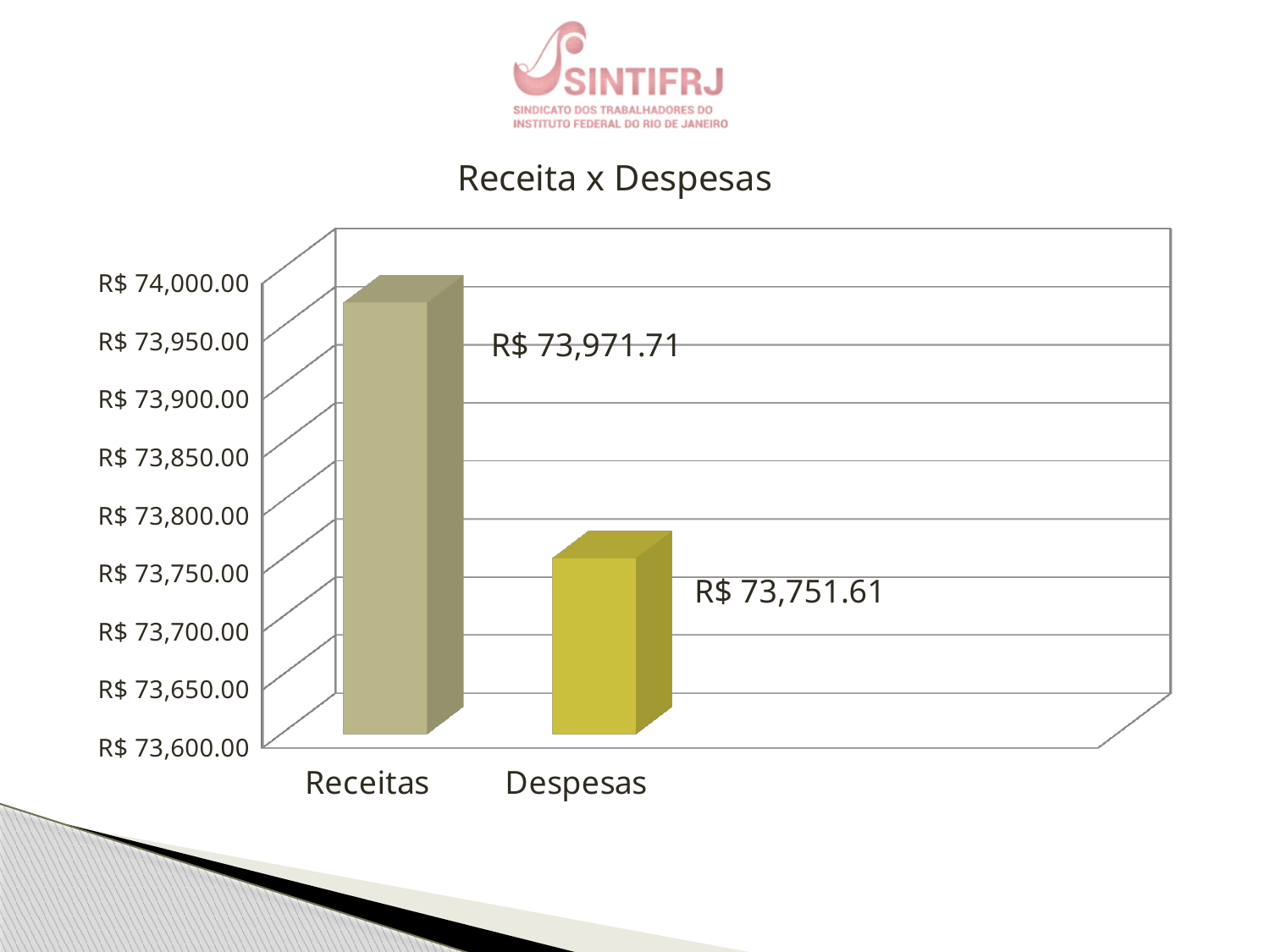
What is the value for Despesas? R$ 73,751.61 Is the value for Despesas greater or less than R$ 73,800.00? less What is the lowest value shown on the vertical axis? R$ 73,600.00 How many categories are shown on the x axis? 2 What is the difference between the values for Receitas and Despesas? R$ 220.10 What is the title of the chart? Receita x Despesas Which is larger, the value for Receitas or the value for Despesas? Receitas What is the value for Receitas? R$ 73,971.71 Which category has the highest value? Receitas Is the value for Receitas greater or less than R$ 73,900.00? greater Which category has the lowest value? Despesas What kind of chart is shown on the slide? Bar chart